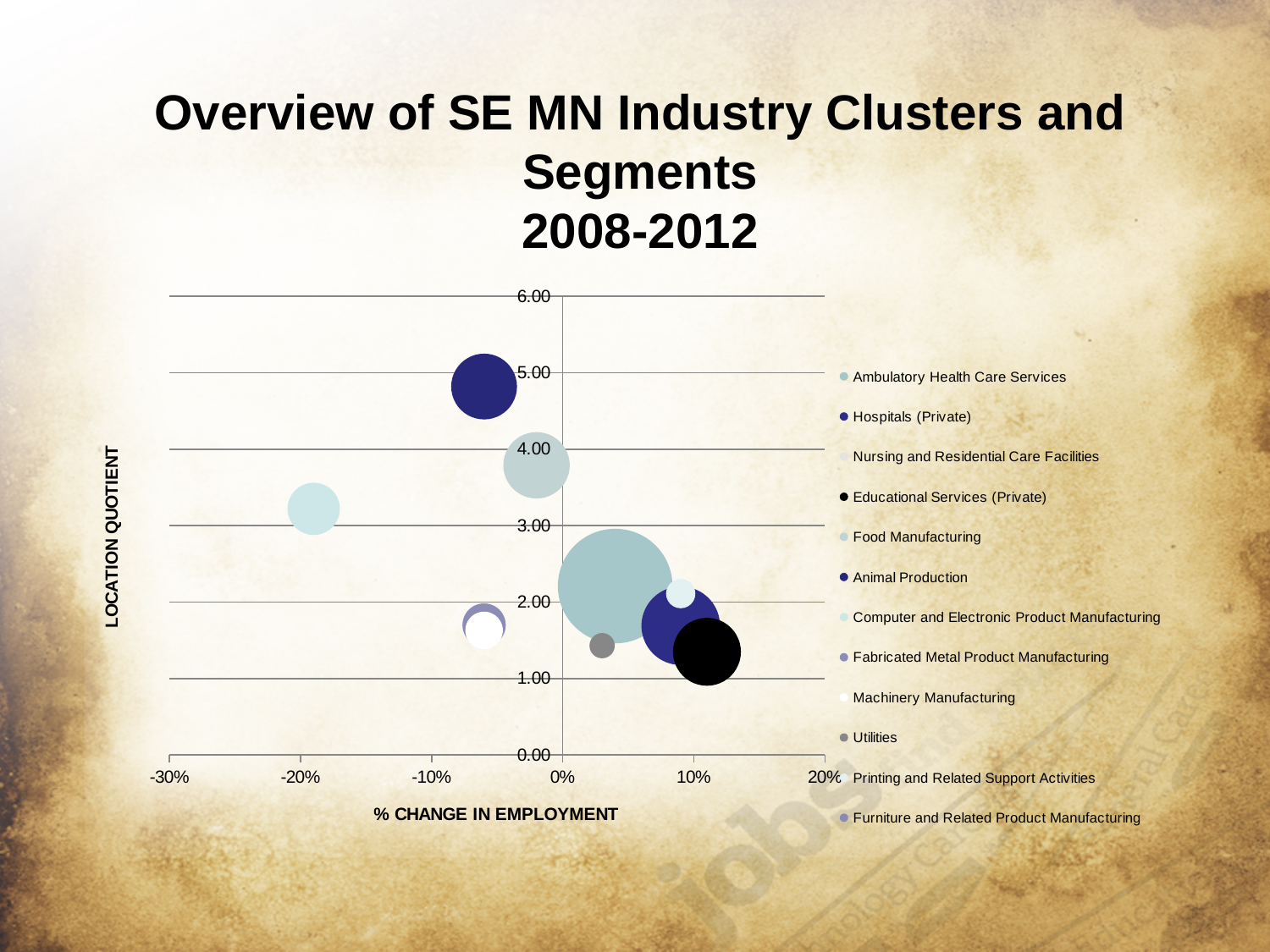
Is the location quotient for Ambulatory Health Care Services greater or less than 3.00? less Which of the two has the higher location quotient: Ambulatory Health Care Services or Educational Services (Private)? Ambulatory Health Care Services How many series does the legend list? 12 Is the location quotient for Educational Services (Private) greater or less than 2.00? less Is the lowest % change in employment plotted on the chart greater or less than -10%? less What is the highest value shown on the vertical axis? 6.00 What is the title of the chart on the slide? Overview of SE MN Industry Clusters and Segments 2008-2012 What is the label of the vertical axis? LOCATION QUOTIENT What kind of chart is shown on the slide? Bubble chart